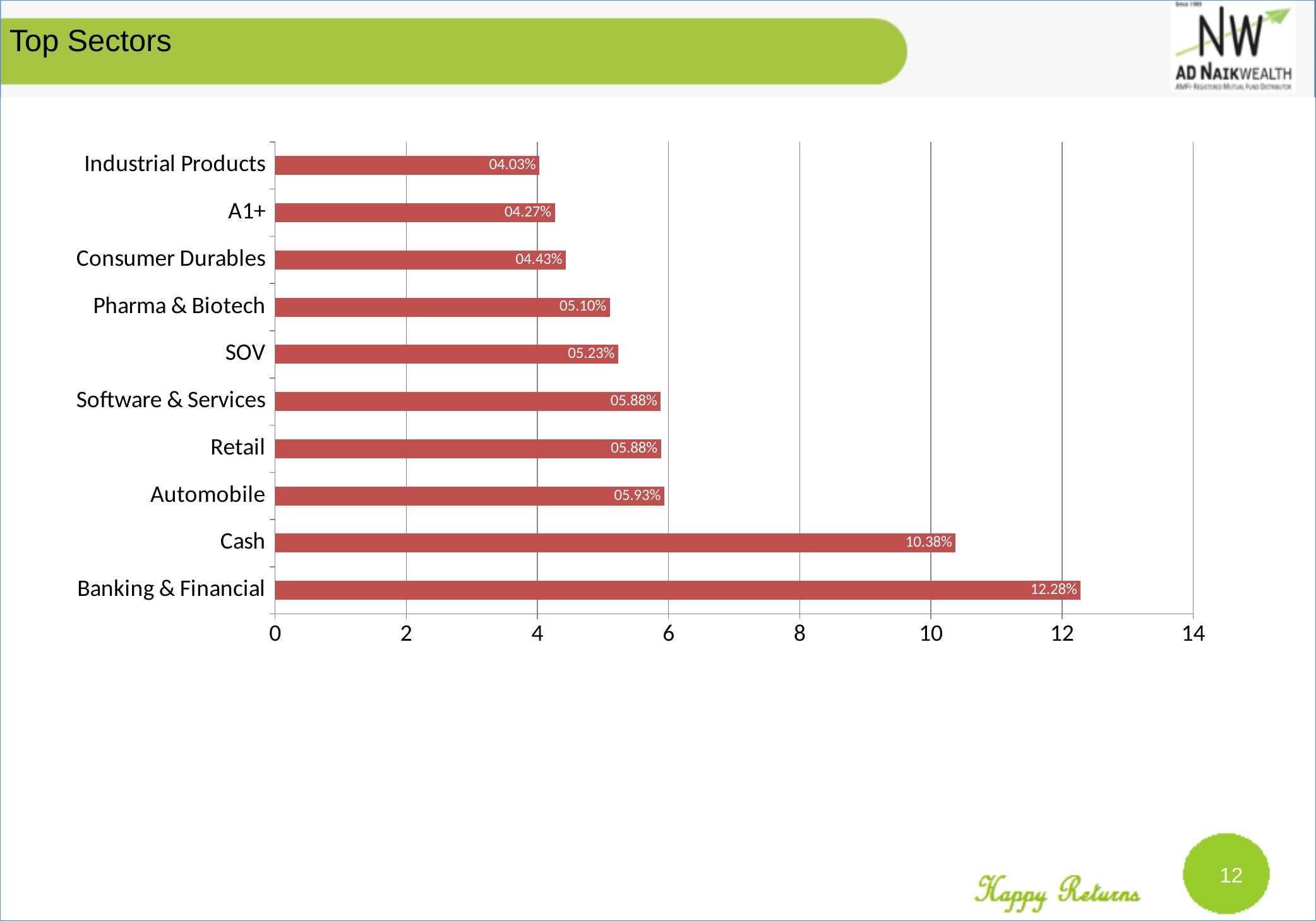
What is the value for Industrial Products? 04.03% What kind of chart is shown on the slide? bar chart What is the value for Pharma & Biotech? 05.10% Is the value for Cash greater or less than 10? greater Which is larger, the value for Automobile or the value for SOV? Automobile Which sector has the highest value? Banking & Financial What is the value for Banking & Financial? 12.28% What is the value for Cash? 10.38% What is the title of the slide containing the chart? Top Sectors Which sector has the lowest value? Industrial Products How many sectors are shown in the chart? 10 What is the difference between the values for Banking & Financial and Cash? 1.90%